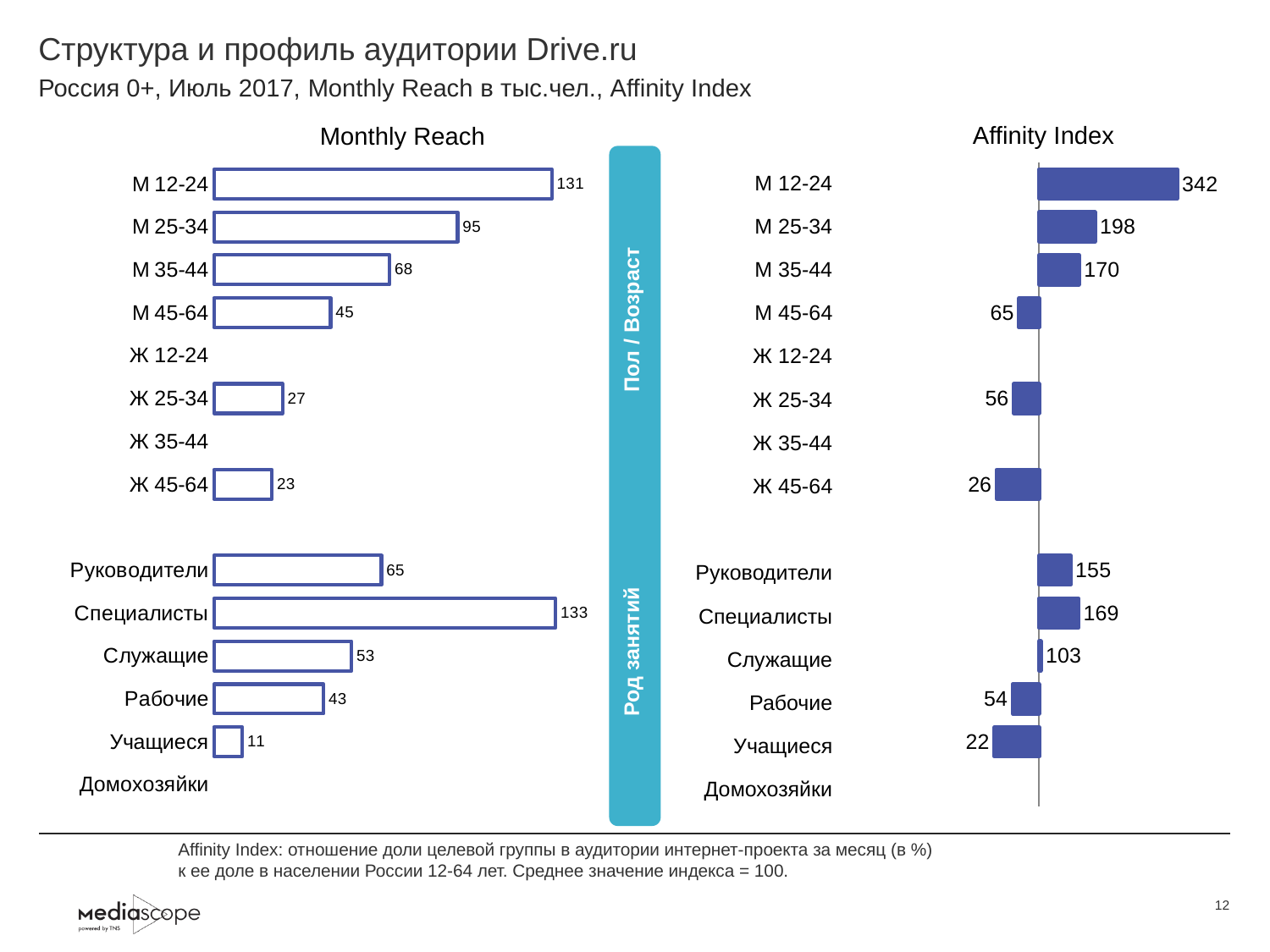
In the Affinity Index chart, what is the difference between М 25-34 and М 35-44? 28 In the Monthly Reach chart, what is the value for Рабочие? 43 In the Monthly Reach chart, what is the difference between М 12-24 and М 25-34? 36 In the Monthly Reach chart, which category has the highest value? Специалисты In the Affinity Index chart, which category has the lowest value among those with a bar? Учащиеся What is the title of the chart on the right side of the slide? Affinity Index In the Affinity Index chart, which category has the highest value? М 12-24 In the Monthly Reach chart, which is larger: Руководители or Служащие? Руководители In the Affinity Index chart, what is the value for Специалисты? 169 What type of chart is the Monthly Reach chart? Bar chart In the Affinity Index chart, which is larger: Ж 25-34 or Ж 45-64? Ж 25-34 In the Monthly Reach chart, what is the value for М 12-24? 131